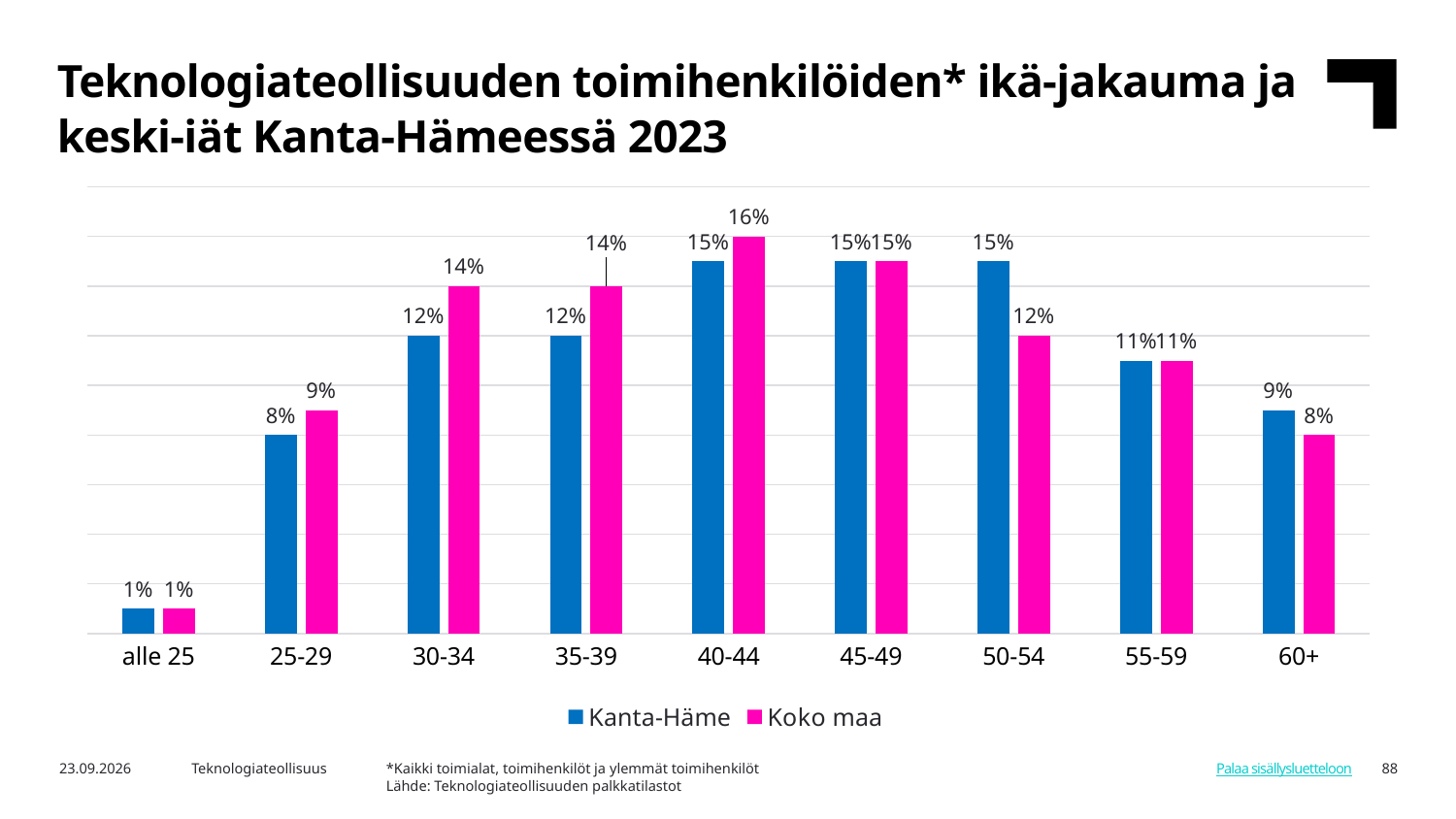
Which age group has the lowest value for Kanta-Häme? alle 25 Which series is shown in pink in the legend? Koko maa In the 60+ age group, which series has the larger value, Kanta-Häme or Koko maa? Kanta-Häme In the 35-39 age group, which series has the larger value, Kanta-Häme or Koko maa? Koko maa How many series does the legend list? 2 What is the value for Kanta-Häme in the 60+ age group? 9% Which age group has the highest value for Koko maa? 40-44 What is the difference between Koko maa and Kanta-Häme in the 50-54 age group? 3% What is the value for Kanta-Häme in the 30-34 age group? 12% What type of chart is shown on the slide? bar chart How many age categories are shown on the x axis? 9 What is the value for Koko maa in the 40-44 age group? 16%